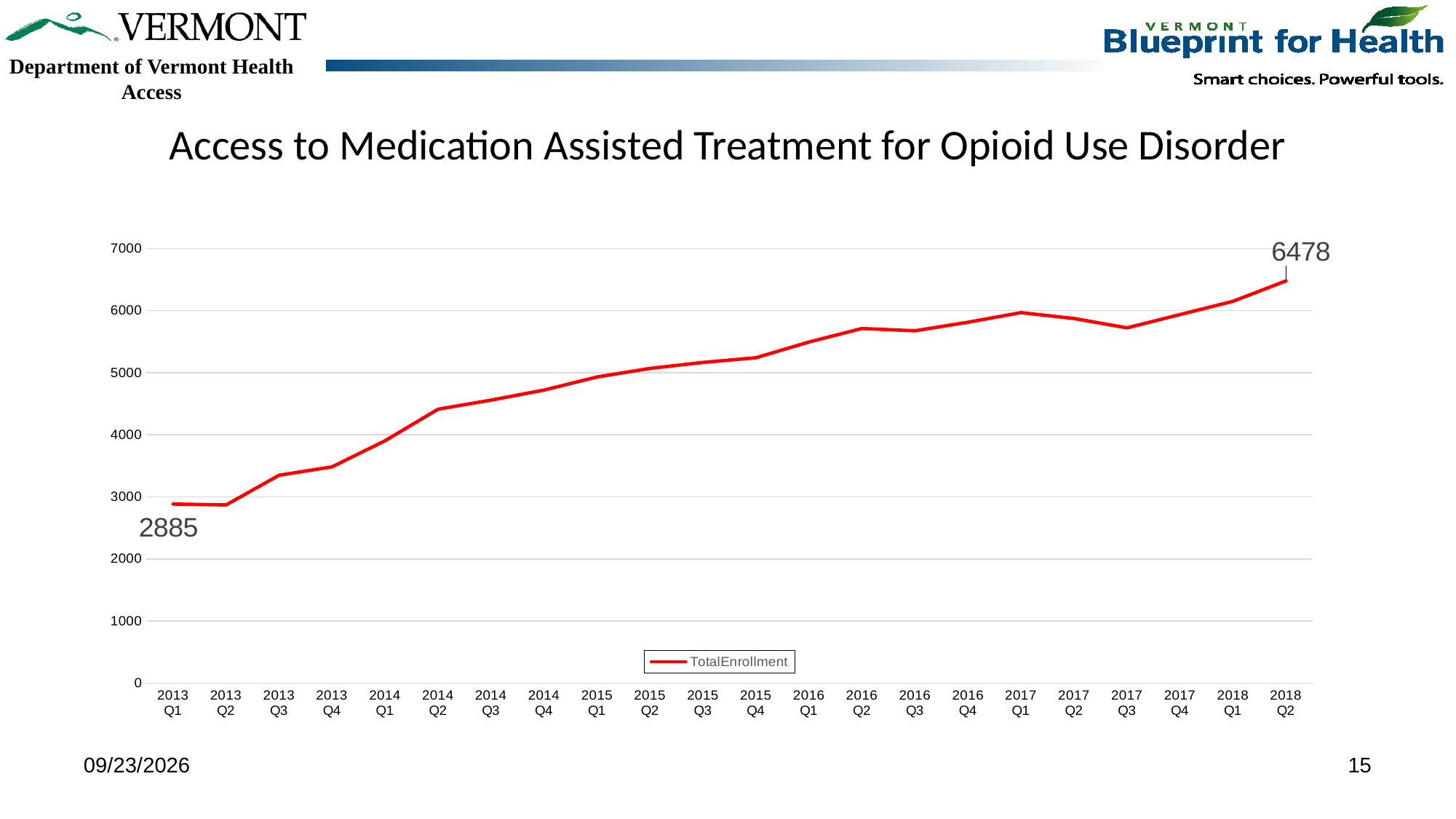
What is the difference between the TotalEnrollment values for 2018 Q2 and 2013 Q1? 3593 How many quarters are plotted on the x axis of the chart? 22 What kind of chart is shown on the slide? line chart What is the TotalEnrollment value for 2018 Q2? 6478 Is the TotalEnrollment value for 2016 Q2 greater or less than 5000? greater Does TotalEnrollment generally rise or fall from 2013 Q1 to 2018 Q2? rise Which quarter has the highest TotalEnrollment value? 2018 Q2 Is the TotalEnrollment value for 2013 Q4 greater or less than 4000? less How many series does the chart's legend list? 1 What is the TotalEnrollment value for 2013 Q1? 2885 Is the TotalEnrollment value for 2014 Q2 greater or less than 4000? greater Which is larger, the TotalEnrollment value for 2013 Q1 or for 2018 Q2? 2018 Q2